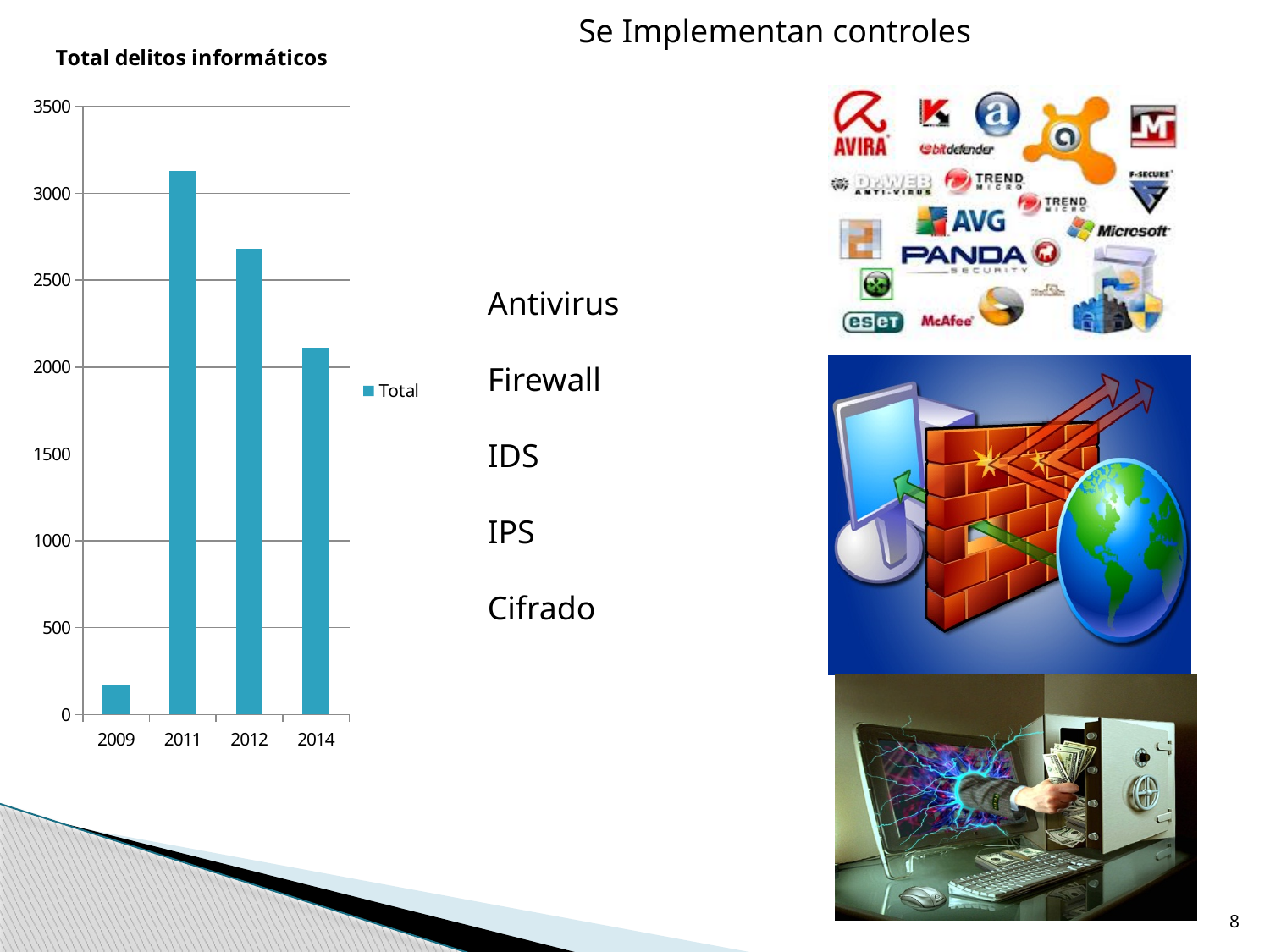
Is the value for 2009 greater or less than 500? less What kind of chart is shown under the title "Total delitos informáticos"? bar chart Do the values rise or fall from 2011 to 2014 along the x axis? fall What is the title of the chart on the slide? Total delitos informáticos How many series does the chart's legend list? 1 How many years (categories) are plotted on the x axis of the chart? 4 Which year has the lowest value in the chart? 2009 What is the name of the series shown in the chart's legend? Total Is the value for 2011 greater or less than 3000? greater Is the value for 2014 greater or less than 2000? greater Which year has the larger value, 2012 or 2014? 2012 Which year has the highest value in the chart? 2011